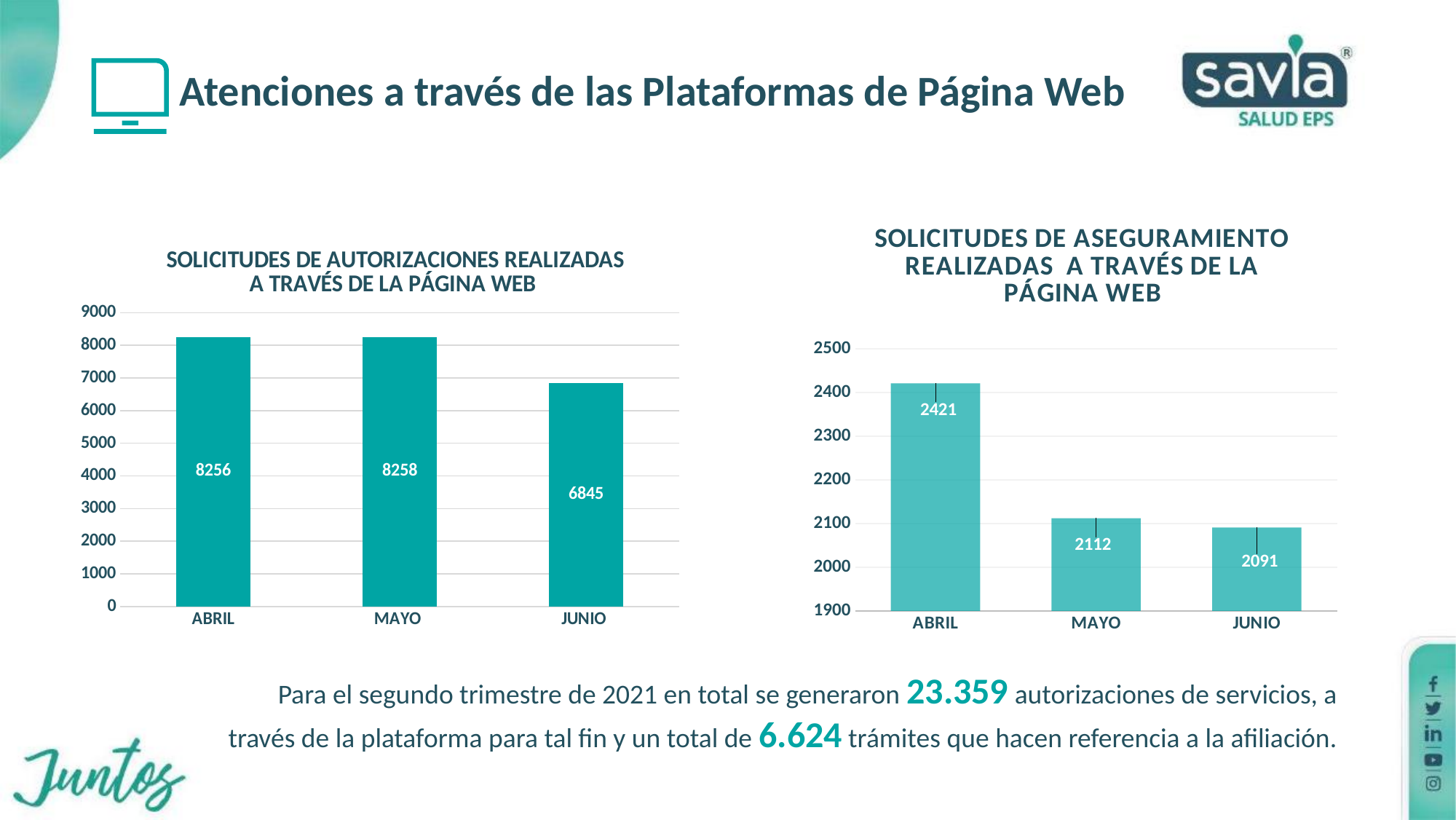
How many months are shown in the chart titled 'SOLICITUDES DE ASEGURAMIENTO REALIZADAS A TRAVÉS DE LA PÁGINA WEB'? 3 In the chart titled 'SOLICITUDES DE ASEGURAMIENTO REALIZADAS A TRAVÉS DE LA PÁGINA WEB', what is the value for MAYO? 2112 In the chart titled 'SOLICITUDES DE ASEGURAMIENTO REALIZADAS A TRAVÉS DE LA PÁGINA WEB', what is the difference between the values for ABRIL and JUNIO? 330 In the chart titled 'SOLICITUDES DE ASEGURAMIENTO REALIZADAS A TRAVÉS DE LA PÁGINA WEB', do the values rise or fall from ABRIL to JUNIO? fall In the chart titled 'SOLICITUDES DE ASEGURAMIENTO REALIZADAS A TRAVÉS DE LA PÁGINA WEB', is the value for ABRIL larger or smaller than the value for MAYO? larger In the chart titled 'SOLICITUDES DE AUTORIZACIONES REALIZADAS A TRAVÉS DE LA PÁGINA WEB', what is the value for JUNIO? 6845 In the chart titled 'SOLICITUDES DE AUTORIZACIONES REALIZADAS A TRAVÉS DE LA PÁGINA WEB', what is the value for ABRIL? 8256 What kind of chart is the one on the left of the slide, titled 'SOLICITUDES DE AUTORIZACIONES REALIZADAS A TRAVÉS DE LA PÁGINA WEB'? bar chart In the chart titled 'SOLICITUDES DE AUTORIZACIONES REALIZADAS A TRAVÉS DE LA PÁGINA WEB', which month has the lowest value? JUNIO In the chart titled 'SOLICITUDES DE ASEGURAMIENTO REALIZADAS A TRAVÉS DE LA PÁGINA WEB', which month has the highest value? ABRIL In the chart titled 'SOLICITUDES DE AUTORIZACIONES REALIZADAS A TRAVÉS DE LA PÁGINA WEB', what is the difference between the values for MAYO and JUNIO? 1413 In the chart titled 'SOLICITUDES DE AUTORIZACIONES REALIZADAS A TRAVÉS DE LA PÁGINA WEB', is the value for JUNIO greater or less than 7000? less